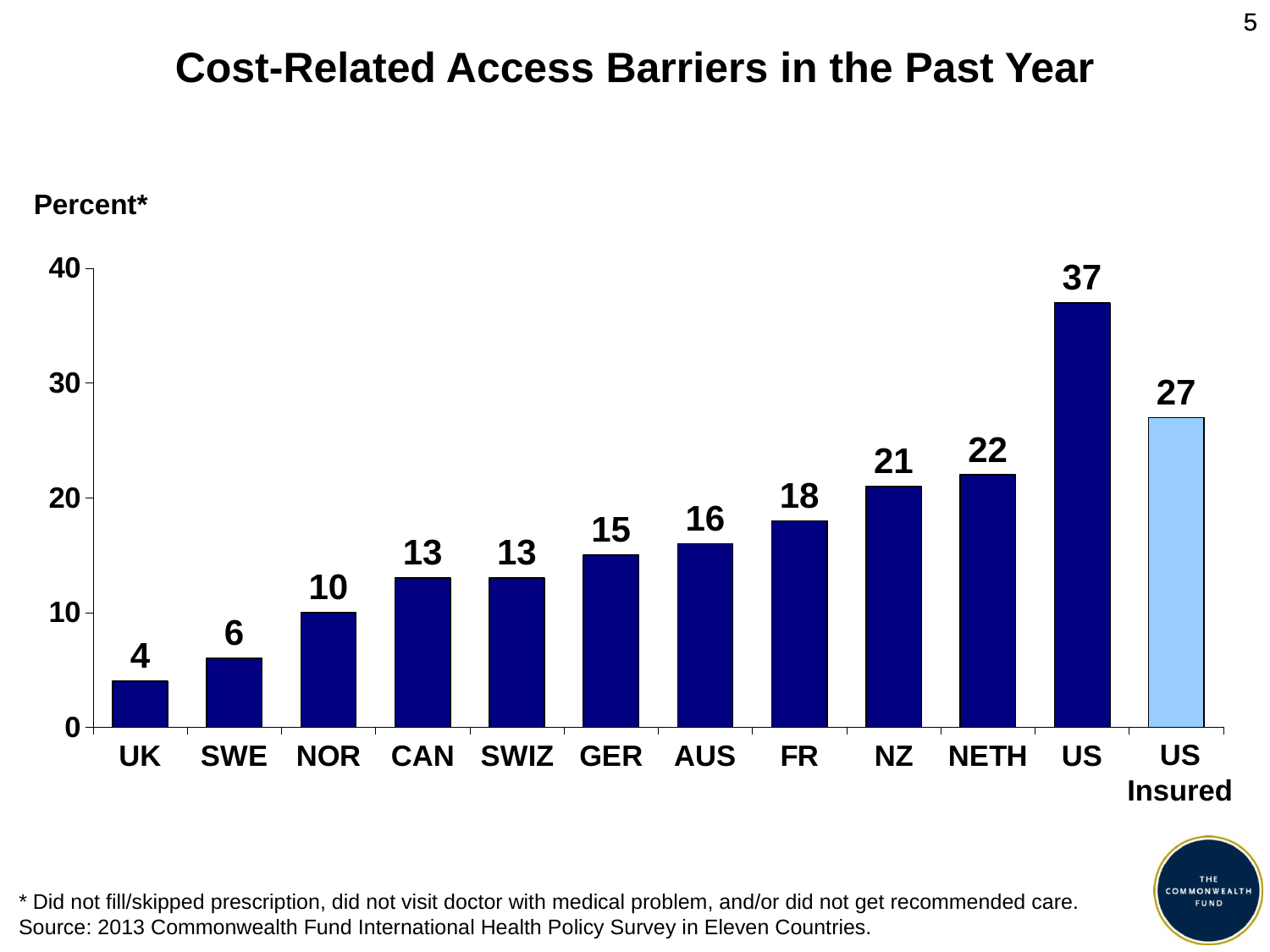
What is the difference between the values for NZ and SWE? 15 What is the title of the chart? Cost-Related Access Barriers in the Past Year What is the difference between the values for US and US Insured? 10 How many categories are shown on the x axis? 12 What is the value for NETH? 22 What kind of chart is shown on the slide? bar chart Is the value for AUS greater or less than 20? less Which category has the highest value? US Which is larger, the value for FR or the value for GER? FR What is the value for the US? 37 Which category has the lowest value? UK What is the value for US Insured? 27